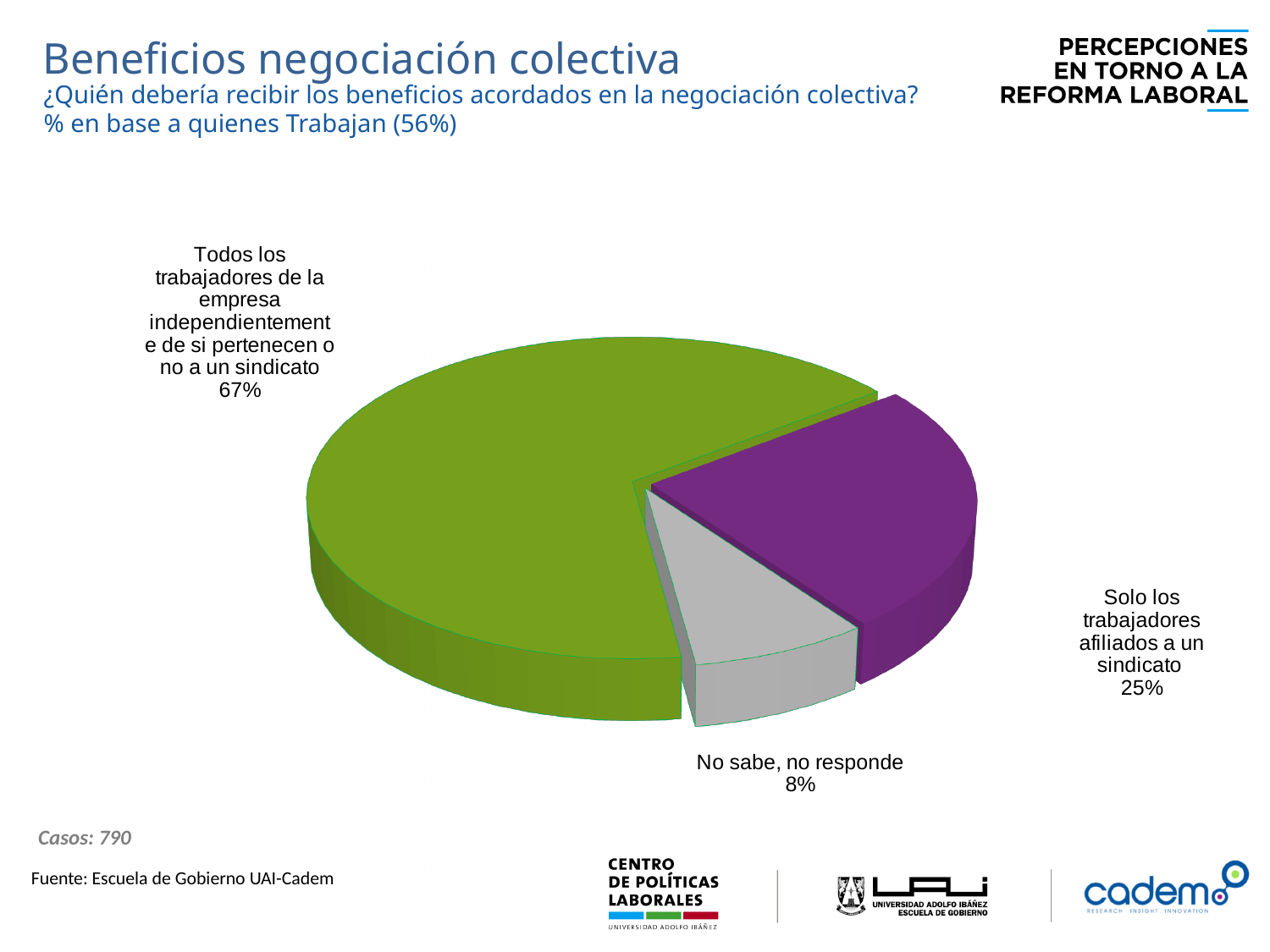
Which category has the smallest slice of the pie? No sabe, no responde How many slices does the pie chart have? 3 Which category has the largest slice of the pie? Todos los trabajadores de la empresa independientemente de si pertenecen o no a un sindicato What percentage is shown for 'Solo los trabajadores afiliados a un sindicato'? 25% What is the difference in percentage points between 'Solo los trabajadores afiliados a un sindicato' and 'No sabe, no responde'? 17 What colour is the slice for 'Solo los trabajadores afiliados a un sindicato'? purple What percentage is shown for 'No sabe, no responde'? 8% What is the title of the slide containing the chart? Beneficios negociación colectiva What percentage is shown for 'Todos los trabajadores de la empresa independientemente de si pertenecen o no a un sindicato'? 67% Which is larger: the share for 'Solo los trabajadores afiliados a un sindicato' or for 'No sabe, no responde'? Solo los trabajadores afiliados a un sindicato What kind of chart is shown on the slide? pie chart What is the difference in percentage points between 'Todos los trabajadores de la empresa...' and 'Solo los trabajadores afiliados a un sindicato'? 42